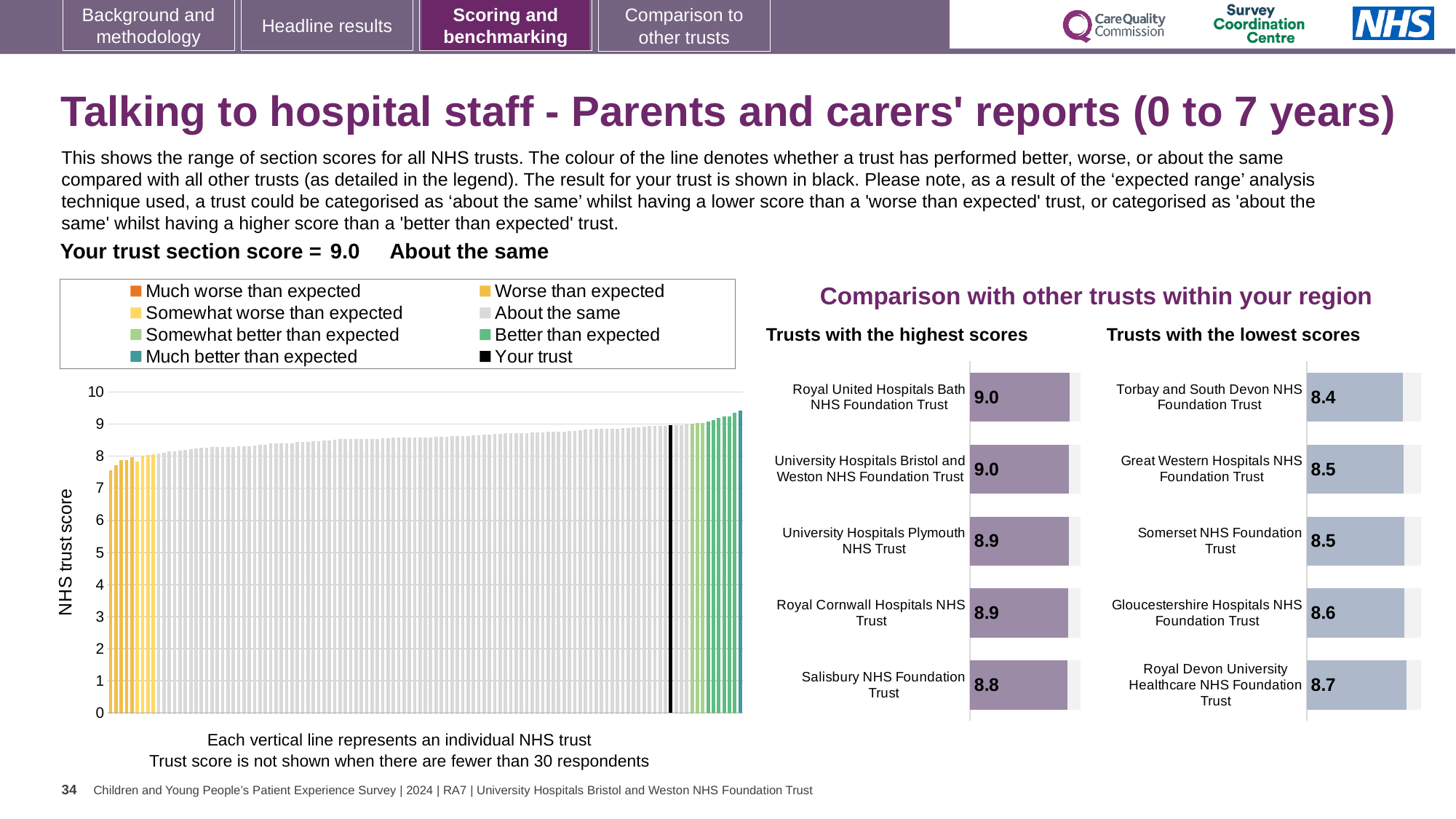
How many entries does the legend above the 'NHS trust score' chart list? 8 In the 'Trusts with the lowest scores' chart, what is the score for Torbay and South Devon NHS Foundation Trust? 8.4 In the 'NHS trust score' chart on the left, do the values rise or fall from left to right? Rise In the 'NHS trust score' chart on the left, is the value for the leftmost trust greater or less than 8? less What kind of chart is the 'NHS trust score' chart on the left of the slide? Bar chart In the 'Trusts with the highest scores' chart, which trust has the lowest score? Salisbury NHS Foundation Trust In the 'Trusts with the lowest scores' chart, which has the higher score: Gloucestershire Hospitals NHS Foundation Trust or Somerset NHS Foundation Trust? Gloucestershire Hospitals NHS Foundation Trust How many trusts are listed in the 'Trusts with the highest scores' chart? 5 In the legend above the 'NHS trust score' chart, what colour represents 'Your trust'? Black In the 'Trusts with the lowest scores' chart, which trust has the lowest score? Torbay and South Devon NHS Foundation Trust In the 'Trusts with the highest scores' chart, what is the score for Salisbury NHS Foundation Trust? 8.8 In the 'Trusts with the lowest scores' chart, what is the difference between the scores of Royal Devon University Healthcare NHS Foundation Trust and Torbay and South Devon NHS Foundation Trust? 0.3